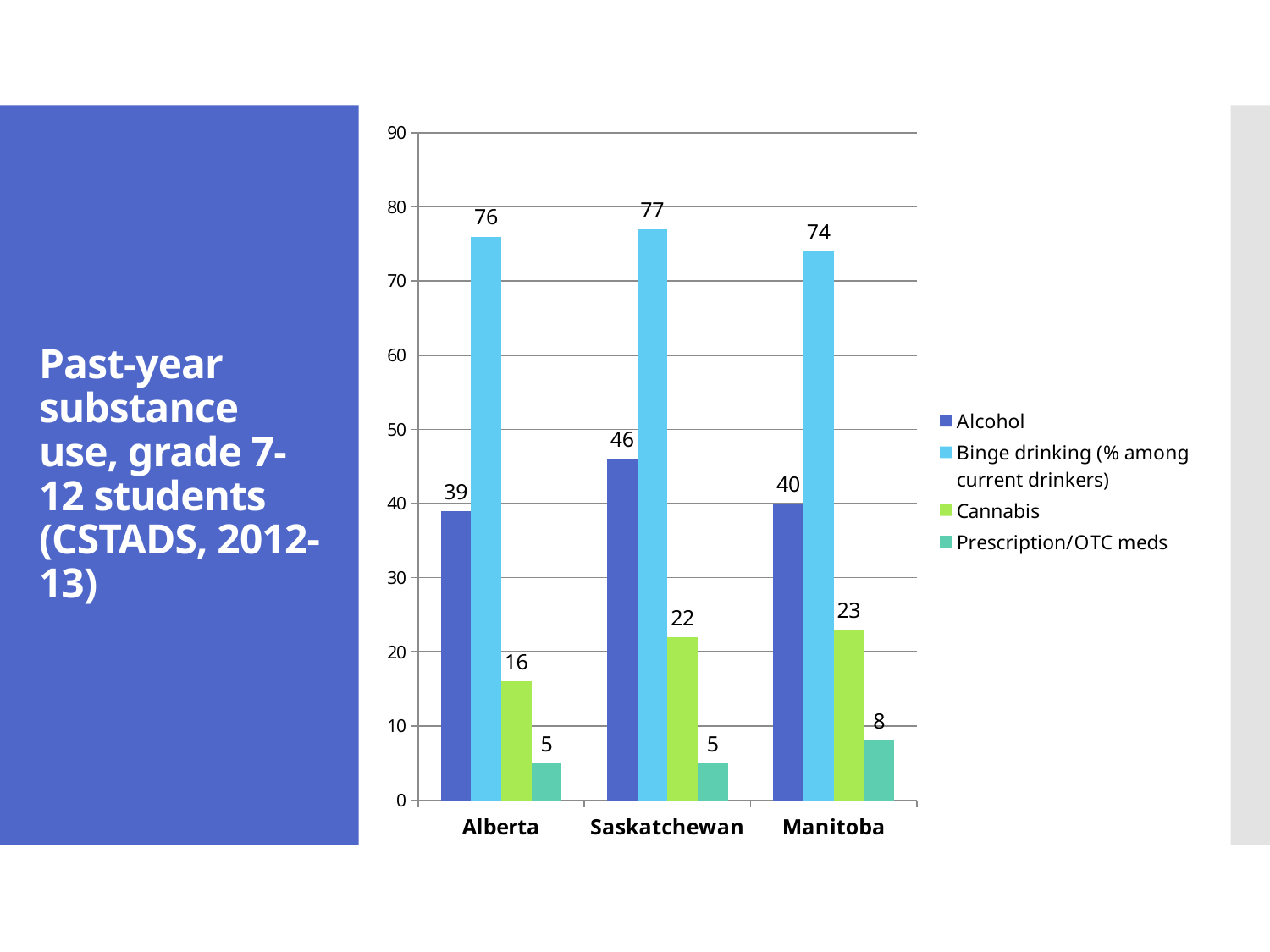
What kind of chart is shown on the slide? Bar chart Which is larger, the Cannabis value for Manitoba or for Saskatchewan? Manitoba What is the Binge drinking value for Manitoba? 74 Which province has the lowest Cannabis value? Alberta Which series is shown in light blue in the legend? Binge drinking (% among current drinkers) What is the Prescription/OTC meds value for Manitoba? 8 What is the difference between the Alcohol values for Saskatchewan and Alberta? 7 Which province has the highest Binge drinking value? Saskatchewan What is the Cannabis value for Alberta? 16 How many series does the legend list? 4 What is the Alcohol value for Saskatchewan? 46 How many provinces are shown on the x axis? 3